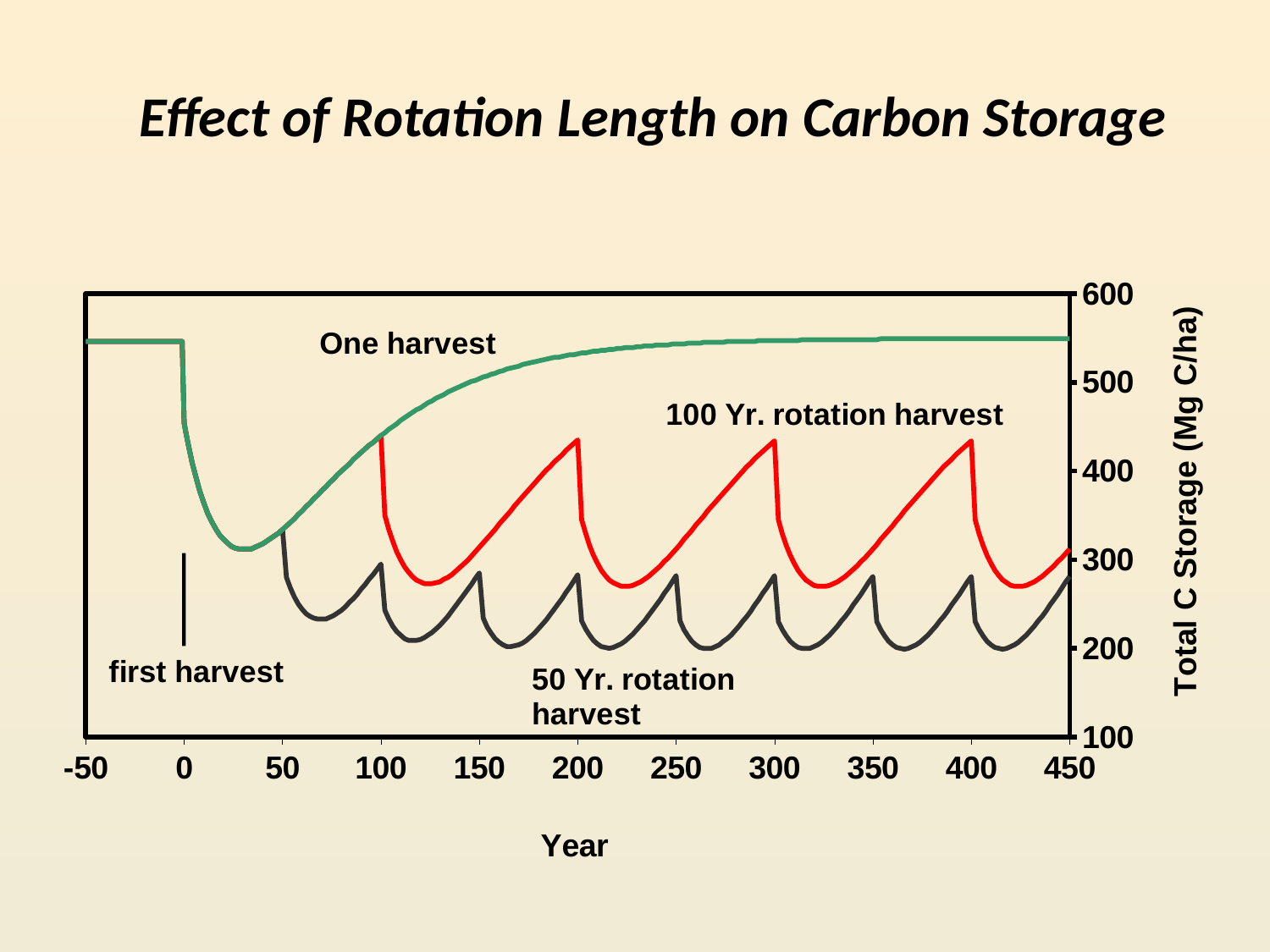
Is the value of the One harvest line at year -50 greater or less than 500? greater At year 450, which line is higher: One harvest or 50 Yr. rotation harvest? One harvest How many tick labels are shown on the Year axis? 11 What is the title of the chart on the slide? Effect of Rotation Length on Carbon Storage Are the peak values of the 100 Yr. rotation harvest line greater or less than 500? less Is the value of the One harvest line at year 450 greater or less than 500? greater Does the One harvest line rise or fall between year 50 and year 450? rise What kind of chart is shown on the slide? line chart How many series (lines) are plotted on the chart? 3 What is the label of the vertical axis? Total C Storage (Mg C/ha) Which series reaches the lowest carbon storage values on the chart? 50 Yr. rotation harvest